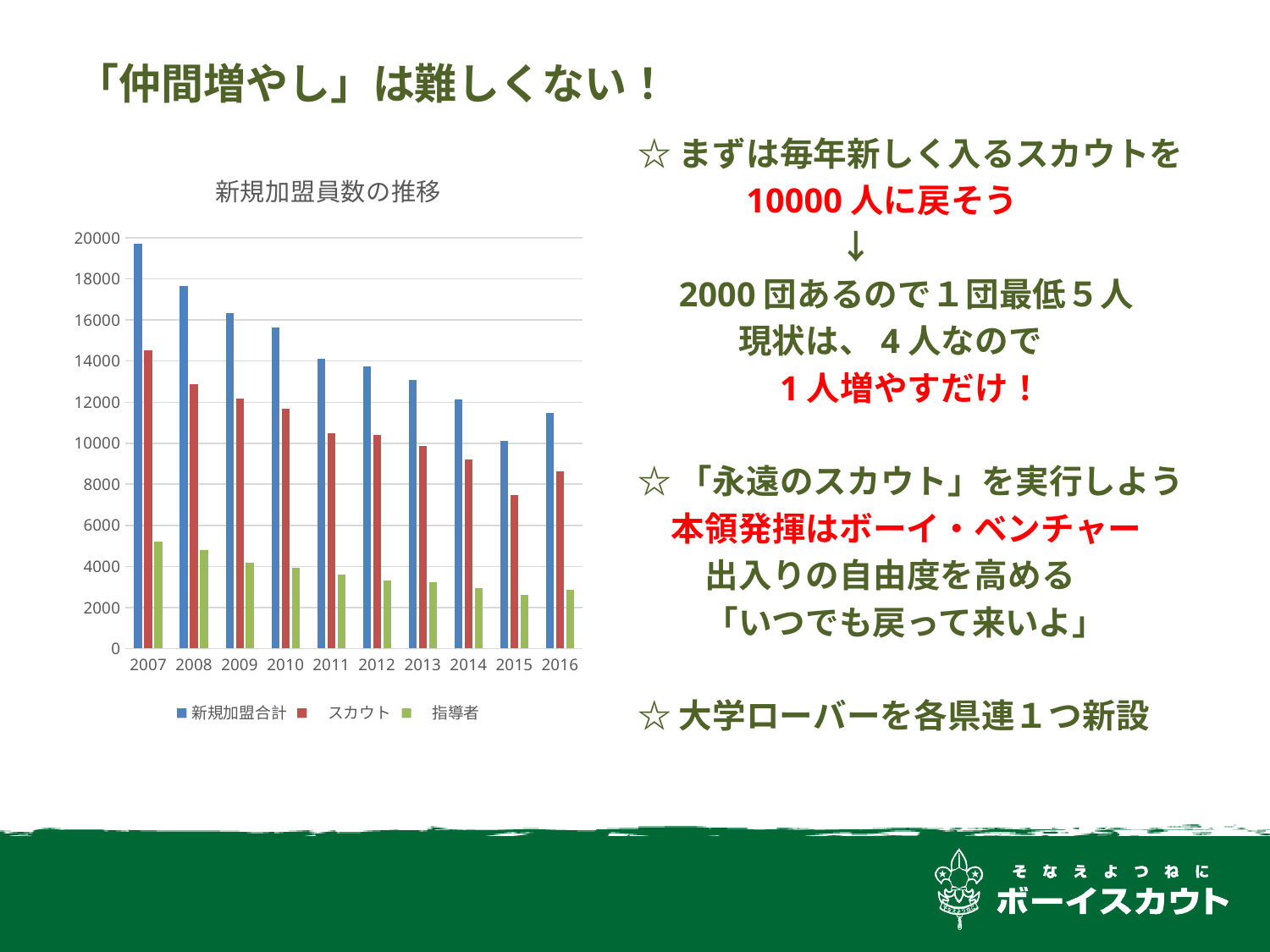
What is the title of the chart? 新規加盟員数の推移 Is the value for スカウト in 2015 greater or less than 8000? less How many years are shown on the x axis of the chart? 10 In which year is the value for 新規加盟合計 lowest? 2015 Is the value for 新規加盟合計 in 2007 greater or less than 18000? greater How many series does the chart's legend list? 3 Which is larger in 2010: the value for 新規加盟合計 or the value for スカウト? 新規加盟合計 In which year is the value for スカウト lowest? 2015 What kind of chart is shown on the slide? bar chart In which year is the value for 新規加盟合計 highest? 2007 Do the values for 新規加盟合計 generally rise or fall from 2007 to 2016? fall Is the value for 指導者 in 2007 greater or less than 4000? greater